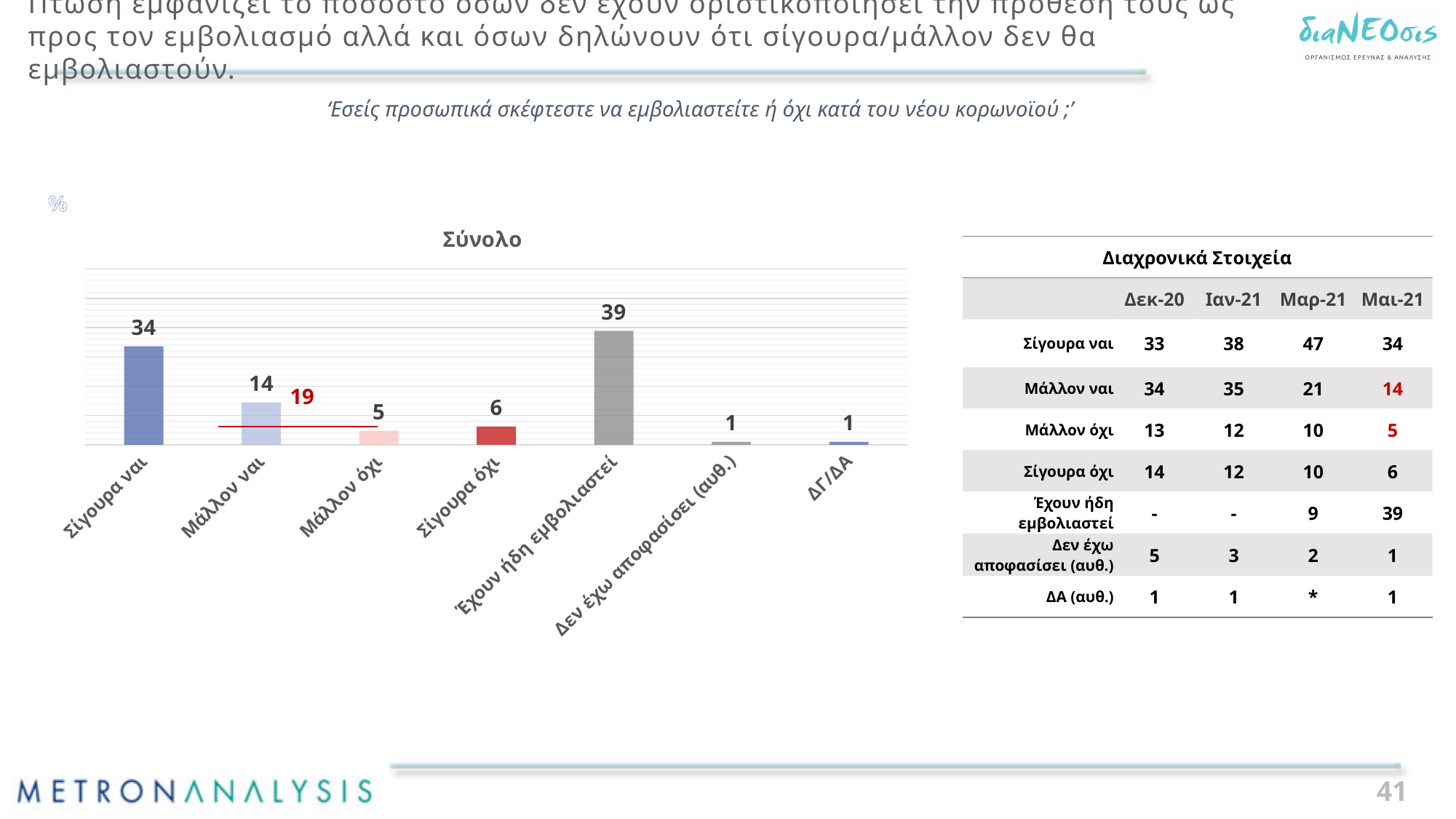
In the 'Σύνολο' chart, which is larger: the value for 'Μάλλον όχι' or the value for 'Σίγουρα όχι'? Σίγουρα όχι In the 'Σύνολο' chart, what is the difference between the values for 'Σίγουρα ναι' and 'Μάλλον ναι'? 20 What is the title of the bar chart on the slide? Σύνολο In the 'Σύνολο' chart, what is the value for 'ΔΓ/ΔΑ'? 1 In the 'Σύνολο' chart, what is the difference between the values for 'Έχουν ήδη εμβολιαστεί' and 'Σίγουρα ναι'? 5 What type of chart is shown under the title 'Σύνολο'? bar chart In the 'Σύνολο' chart, what is the value for 'Σίγουρα ναι'? 34 In the 'Σύνολο' chart, what is the value for 'Έχουν ήδη εμβολιαστεί'? 39 In the 'Σύνολο' chart, which category has the highest value? Έχουν ήδη εμβολιαστεί In the 'Σύνολο' chart, what is the value for 'Μάλλον ναι'? 14 In the 'Σύνολο' chart, how many categories are shown on the x axis? 7 In the 'Σύνολο' chart, what is the value for 'Σίγουρα όχι'? 6